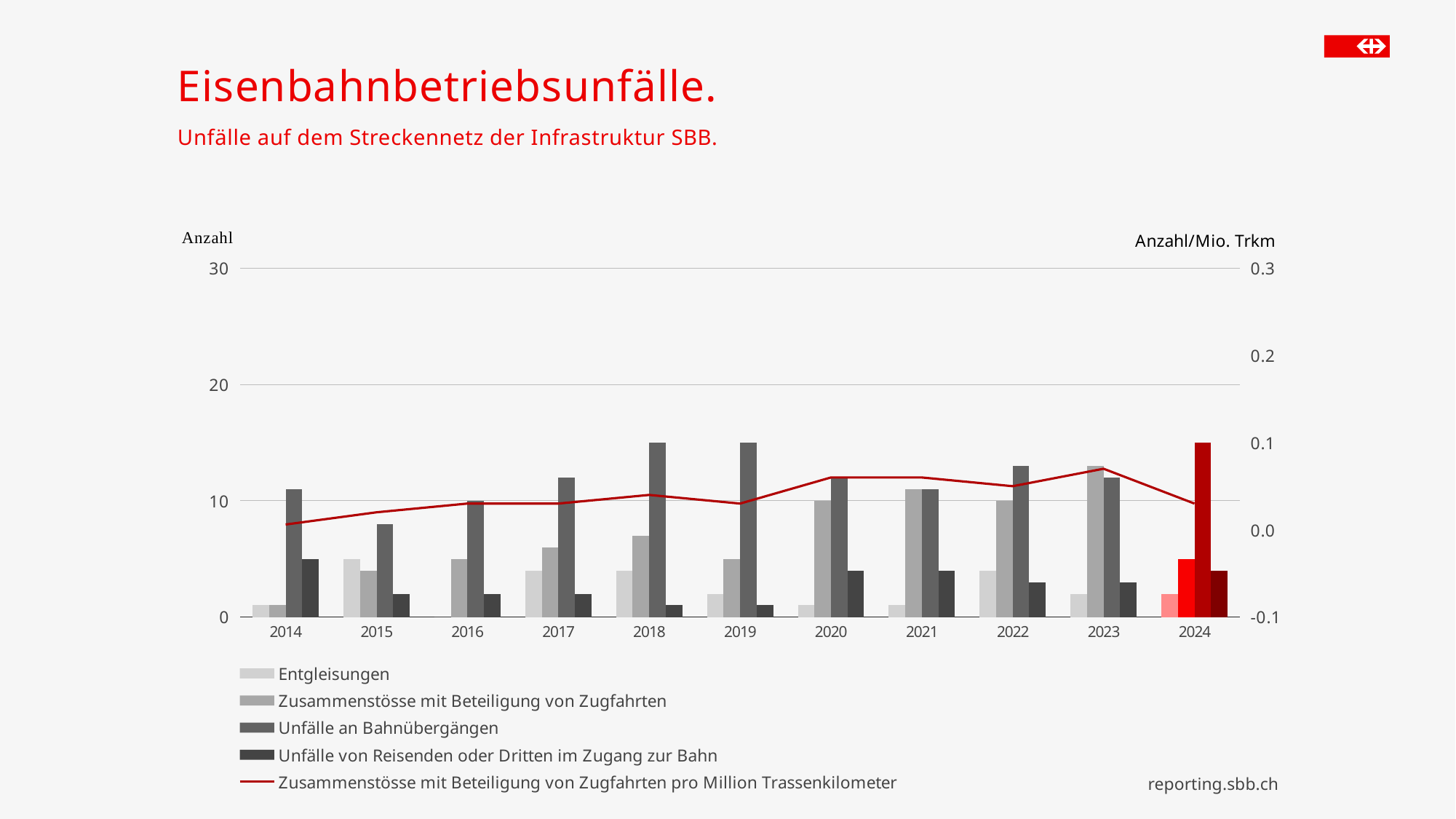
What kind of chart is shown on the slide? bar chart with a line Does the line for Zusammenstösse mit Beteiligung von Zugfahrten pro Million Trassenkilometer rise or fall from 2014 to 2020? rise Is the value for Unfälle an Bahnübergängen in 2018 greater or less than 10? greater How many years are shown on the x axis? 11 Is the value for Unfälle von Reisenden oder Dritten im Zugang zur Bahn in 2021 greater or less than 10? less What is the title of the slide? Eisenbahnbetriebsunfälle. How many series does the legend list? 5 In what colour are the bars for 2024 drawn? red Is the value for Unfälle an Bahnübergängen in 2024 greater or less than 10? greater In 2019, which is larger: Unfälle an Bahnübergängen or Entgleisungen? Unfälle an Bahnübergängen In 2017, which is larger: Unfälle an Bahnübergängen or Zusammenstösse mit Beteiligung von Zugfahrten? Unfälle an Bahnübergängen